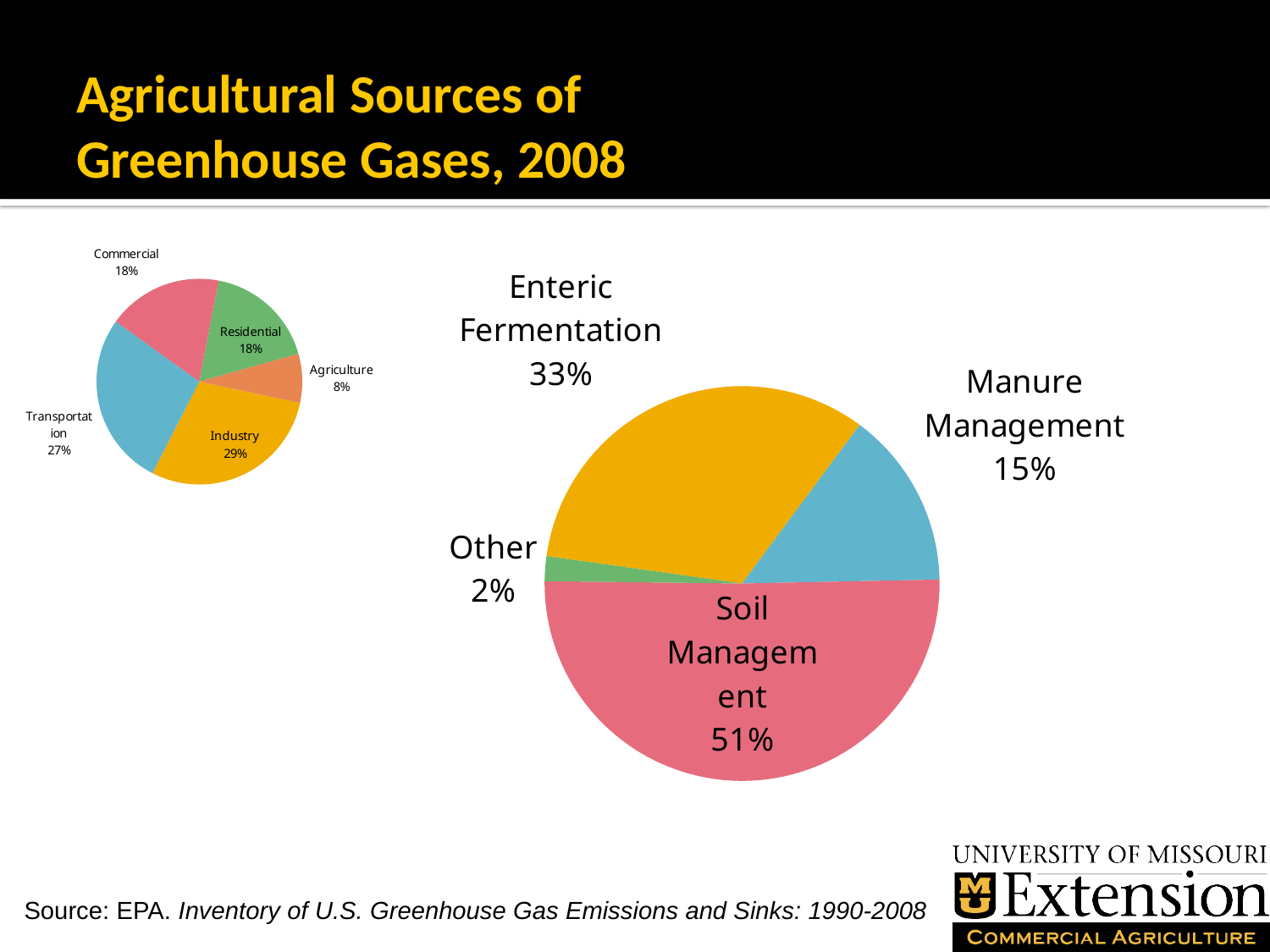
In the large pie chart on the right, which category has the smallest share? Other In the small pie chart on the left, what share is Industry? 29% In the large pie chart on the right, which category has the largest share? Soil Management In the small pie chart on the left, which is larger, Transportation or Commercial? Transportation In the large pie chart on the right, how many slices are there? 4 In the small pie chart on the left, how many categories are shown? 5 In the small pie chart on the left, what share is Agriculture? 8% In the large pie chart on the right, what share is Soil Management? 51% In the large pie chart on the right, what is the difference between the Enteric Fermentation and Manure Management shares? 18% What kind of chart is the large chart on the right? Pie chart In the small pie chart on the left, which category has the largest share? Industry In the large pie chart on the right, what share is Enteric Fermentation? 33%